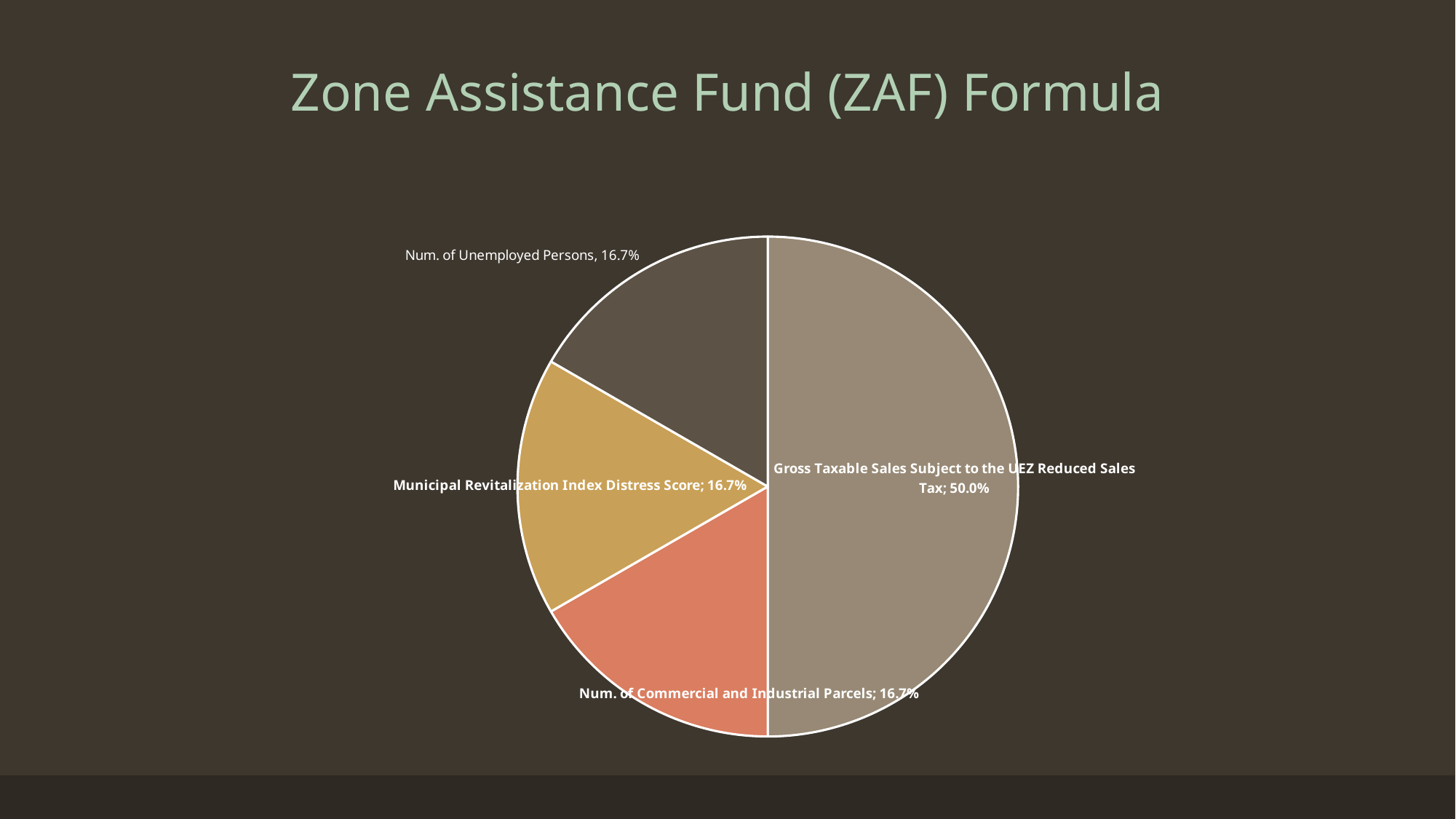
What share of the pie does Municipal Revitalization Index Distress Score represent? 16.7% What share of the pie does Num. of Commercial and Industrial Parcels represent? 16.7% Which slice of the pie is the largest? Gross Taxable Sales Subject to the UEZ Reduced Sales Tax What share of the pie does Gross Taxable Sales Subject to the UEZ Reduced Sales Tax represent? 50.0% What is the title of the slide containing the pie chart? Zone Assistance Fund (ZAF) Formula Which is larger: the share for Gross Taxable Sales Subject to the UEZ Reduced Sales Tax or the share for Municipal Revitalization Index Distress Score? Gross Taxable Sales Subject to the UEZ Reduced Sales Tax What colour is the slice for Num. of Commercial and Industrial Parcels? orange What is the difference between the share for Gross Taxable Sales Subject to the UEZ Reduced Sales Tax and the share for Num. of Unemployed Persons? 33.3% What is the combined share of the three slices labelled 16.7%? 50.1% What kind of chart is shown on the slide? pie chart How many slices does the pie chart have? 4